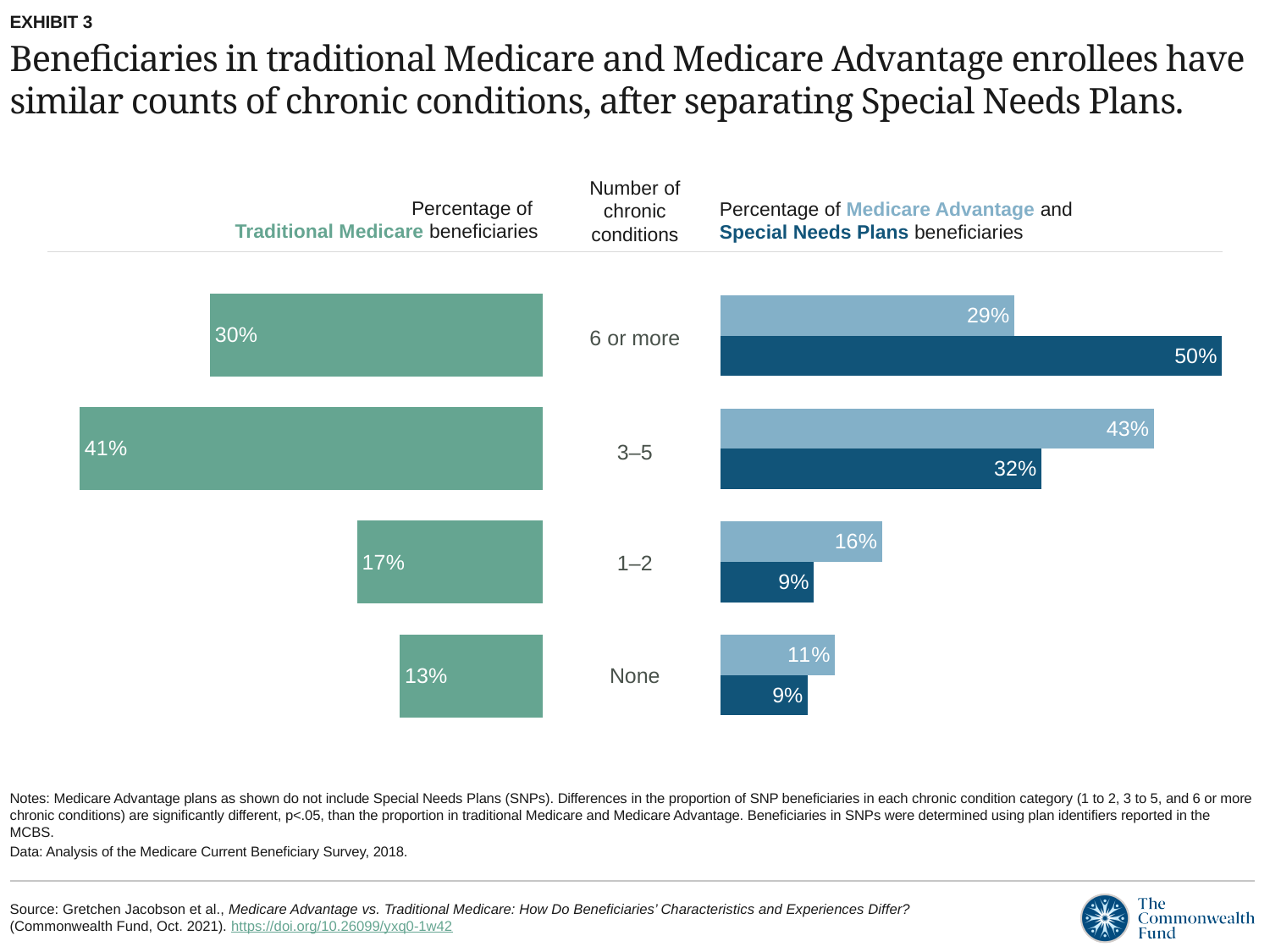
In the right chart, what percentage of Special Needs Plans beneficiaries have 6 or more chronic conditions? 50% In the left chart (Traditional Medicare), which number-of-chronic-conditions category has the highest percentage? 3–5 How many series does the right chart show? 2 In the left chart (Percentage of Traditional Medicare beneficiaries), what percentage of beneficiaries have 3–5 chronic conditions? 41% In the right chart, which category has the highest percentage for Special Needs Plans beneficiaries? 6 or more In the left chart (Traditional Medicare), which number-of-chronic-conditions category has the lowest percentage? None In the right chart, what is the difference between the Special Needs Plans and Medicare Advantage percentages for 6 or more chronic conditions? 21 percentage points In the right chart, for 3–5 chronic conditions, which is larger: the Medicare Advantage percentage or the Special Needs Plans percentage? Medicare Advantage In the left chart (Traditional Medicare), what is the difference between the percentages for 3–5 and 6 or more chronic conditions? 11 percentage points In the right chart, what percentage of Medicare Advantage beneficiaries have 1–2 chronic conditions? 16% How many number-of-chronic-conditions categories are shown on the slide? 4 What type of chart is used on this slide? Bar chart